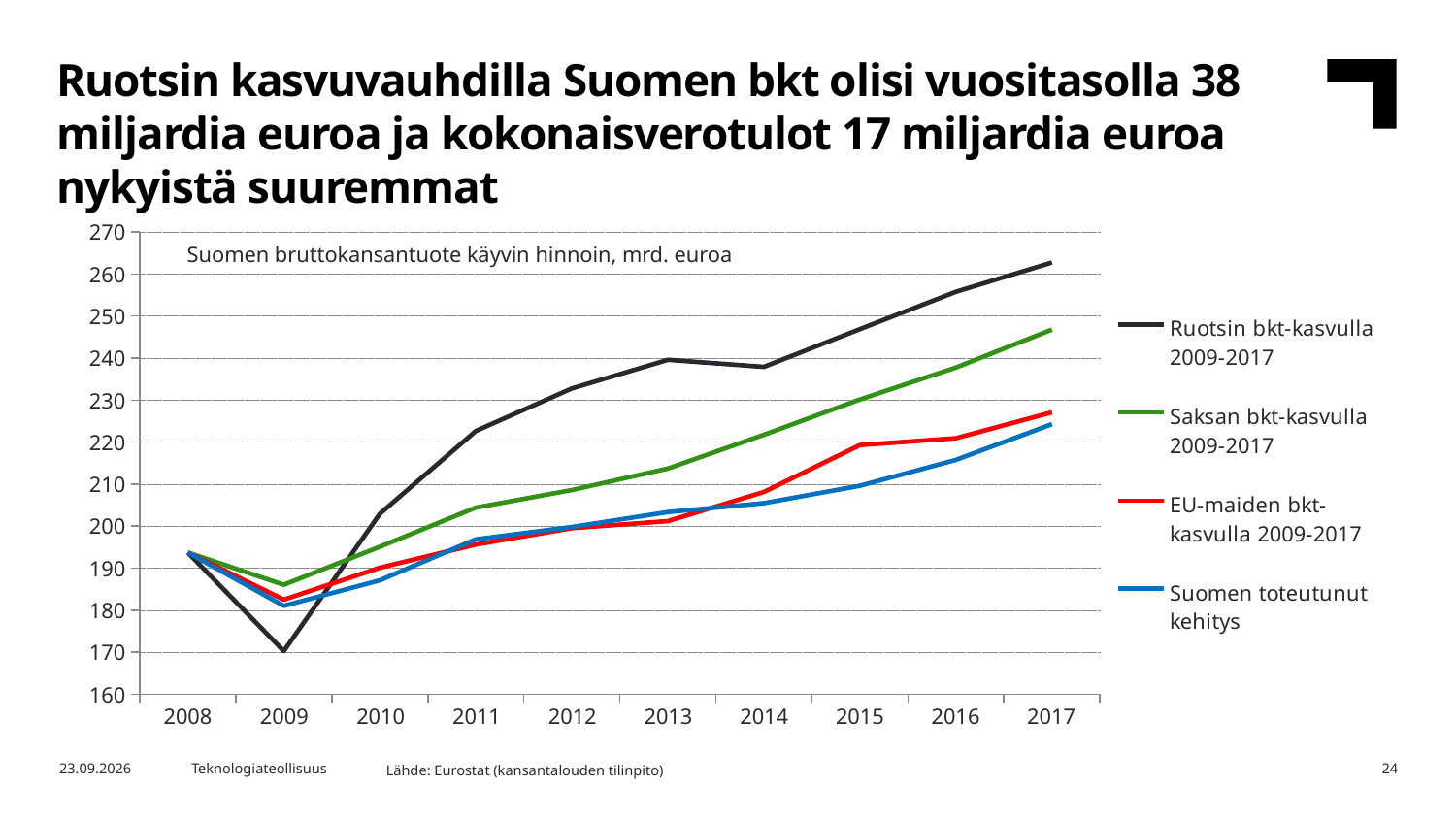
Is the value for Saksan bkt-kasvulla 2009-2017 in 2017 greater or less than 240? greater Is the value for Ruotsin bkt-kasvulla 2009-2017 in 2017 greater or less than 250? greater Is the value for Ruotsin bkt-kasvulla 2009-2017 in 2009 greater or less than 180? less What is the title shown inside the chart area? Suomen bruttokansantuote käyvin hinnoin, mrd. euroa Does the Ruotsin bkt-kasvulla 2009-2017 line rise or fall from 2009 to 2017? rise Which series has the lowest value in 2009? Ruotsin bkt-kasvulla 2009-2017 Which series has the highest value in 2017? Ruotsin bkt-kasvulla 2009-2017 In 2017, which is larger: Saksan bkt-kasvulla 2009-2017 or EU-maiden bkt-kasvulla 2009-2017? Saksan bkt-kasvulla 2009-2017 How many series does the legend list? 4 How many years are shown on the x axis? 10 What kind of chart is shown on the slide? line chart